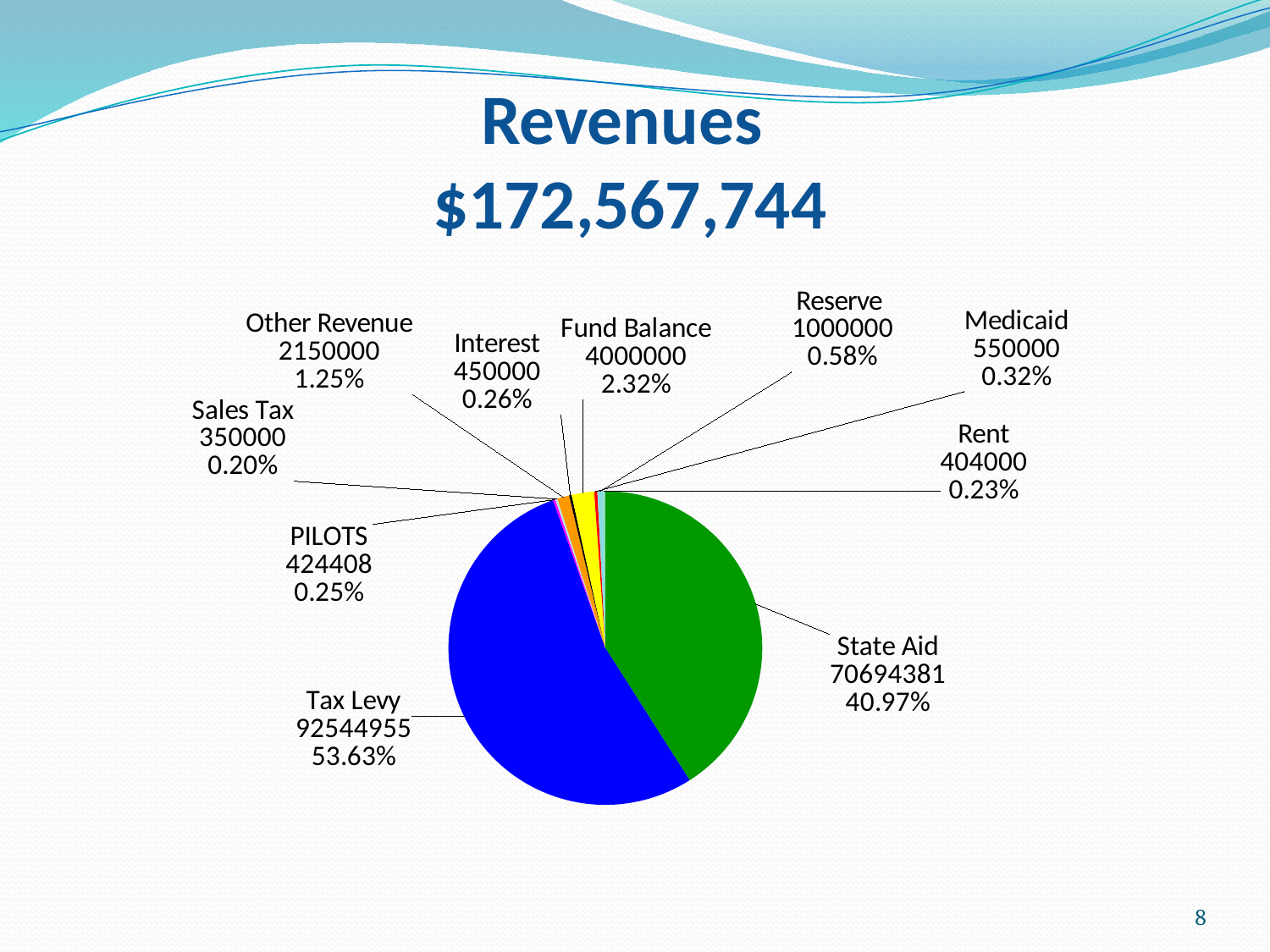
Which category has the smallest slice of the pie? Sales Tax What percentage is shown for Other Revenue? 1.25% What kind of chart is shown on the slide? pie chart What is the value for Fund Balance? 4000000 Which is larger, the value for Reserve or the value for Medicaid? Reserve What share of the pie does State Aid represent? 40.97% Which category has the largest slice of the pie? Tax Levy What is the value for Rent? 404000 What is the value for Tax Levy? 92544955 How many categories are shown in the pie chart? 10 What total revenue amount is shown in the slide title? $172,567,744 What is the difference between the Tax Levy value and the State Aid value? 21850574